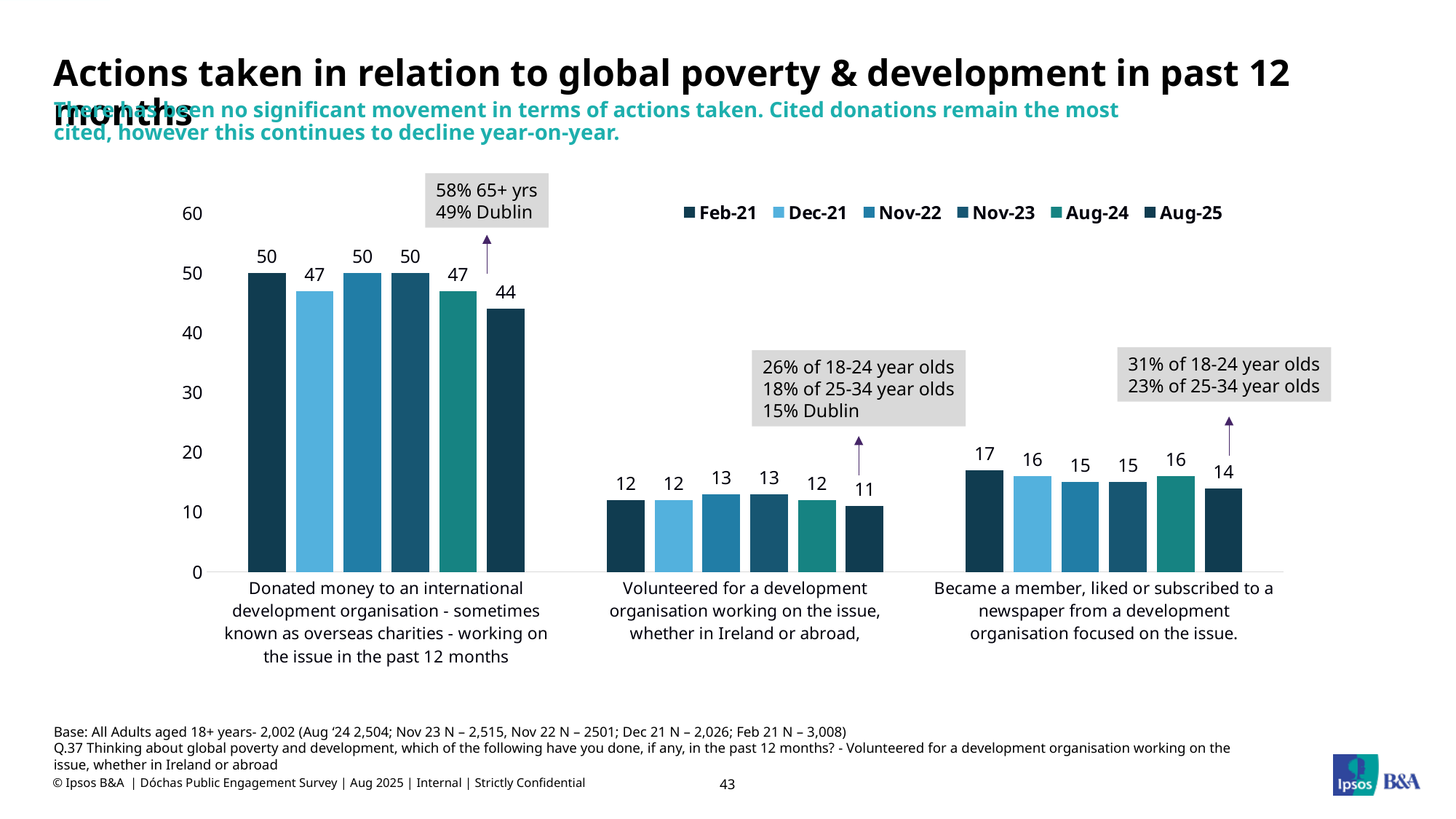
What is the Aug-25 value for 'Donated money to an international development organisation'? 44 Which survey wave has the lowest value for 'Donated money to an international development organisation'? Aug-25 What is the Nov-22 value for 'Volunteered for a development organisation working on the issue'? 13 For 'Donated money to an international development organisation', which is larger: the Aug-24 value or the Aug-25 value? Aug-24 How many categories (actions) are shown on the x axis? 3 Which series is listed first in the legend? Feb-21 Which survey wave has the lowest value for 'Volunteered for a development organisation working on the issue'? Aug-25 What is the difference between the Feb-21 and Aug-25 values for 'Donated money to an international development organisation'? 6 Which survey wave has the highest value for 'Became a member, liked or subscribed to a newspaper from a development organisation'? Feb-21 What is the Feb-21 value for 'Became a member, liked or subscribed to a newspaper from a development organisation'? 17 What kind of chart is shown on the slide? Bar chart How many series does the legend list? 6